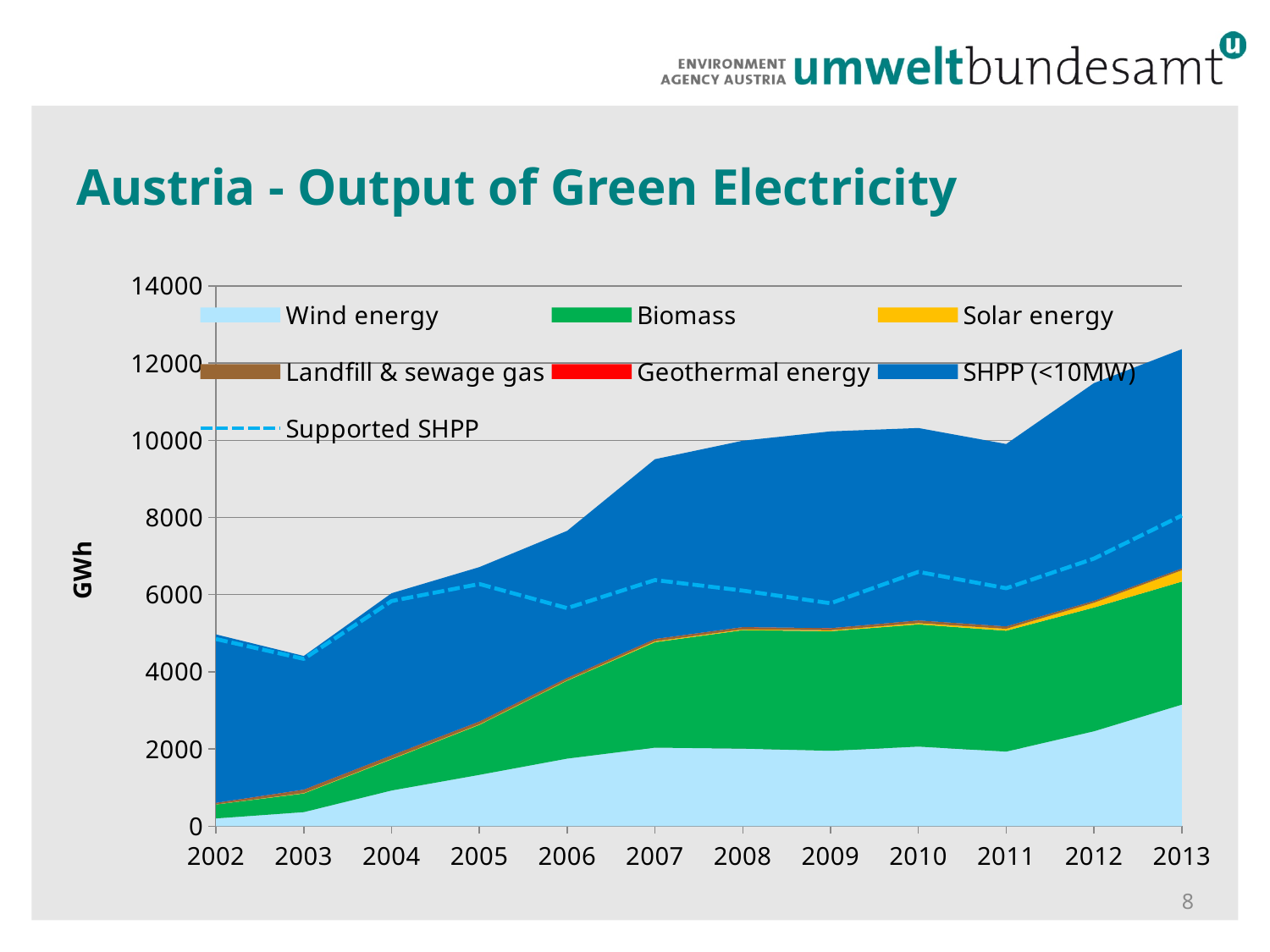
How many years are shown along the x axis? 12 Is the total green electricity output in 2013 greater or less than 12000 GWh? greater Which series is drawn as a dashed line rather than a filled area? Supported SHPP Is the total green electricity output in 2003 greater or less than 5000 GWh? less What kind of chart is shown on the slide? Stacked area chart How many series does the legend list? 7 Is the Supported SHPP value in 2002 greater or less than 4000 GWh? greater Which is larger, the total output in 2013 or the total output in 2002? 2013 What is the unit shown on the y axis? GWh Does the total green electricity output generally rise or fall from 2002 to 2013? rise